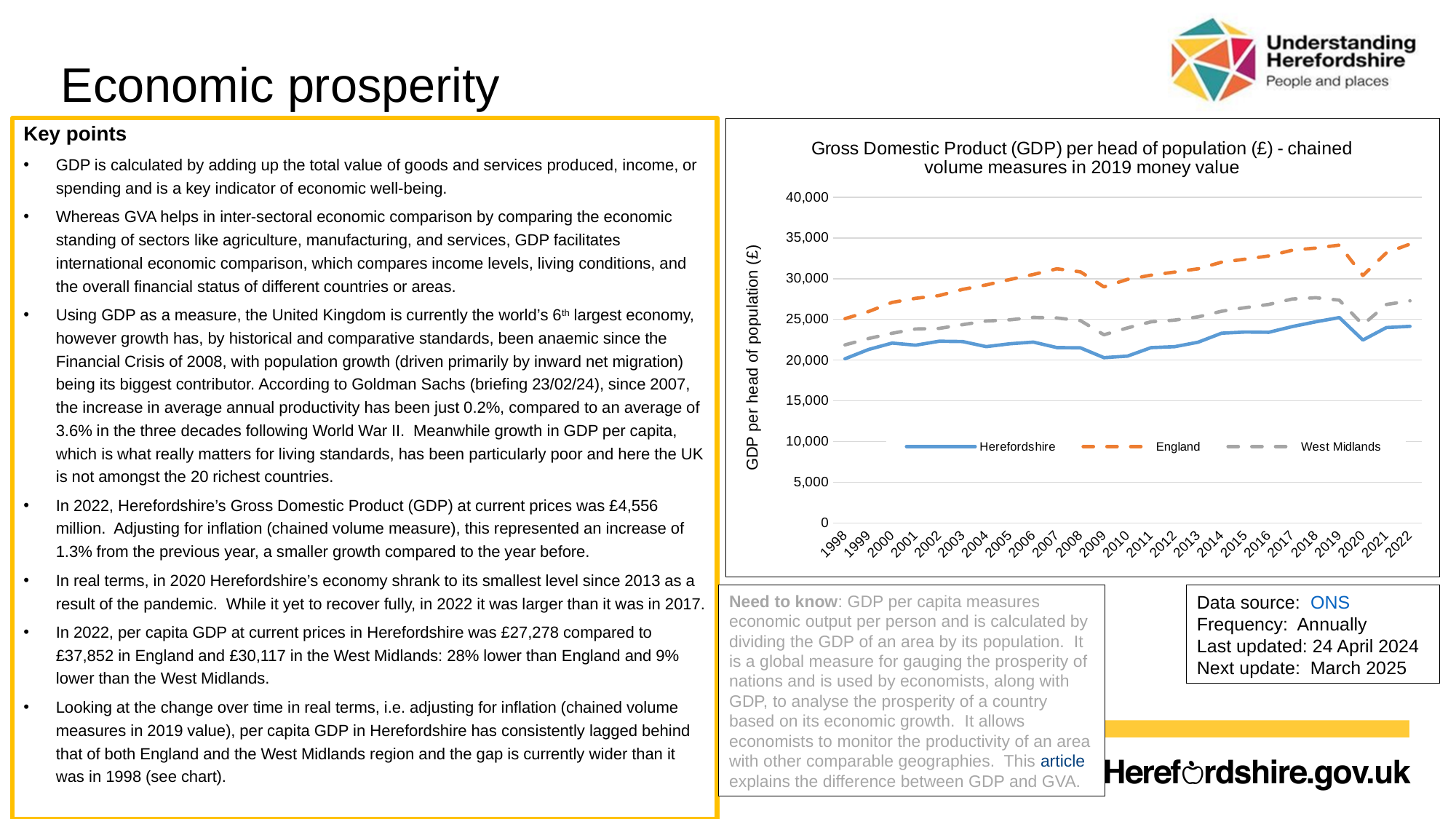
Is the value for England in 2022 greater or less than 30,000? greater How many years are plotted along the x axis of the chart? 25 Which area has the highest GDP per head of population in 2022? England How many series does the chart's legend list? 3 Does the value for England rise or fall between 2019 and 2020? Fall Is the value for Herefordshire in 2022 greater or less than 25,000? less In 2010, which is larger: the value for Herefordshire or the value for West Midlands? West Midlands What kind of chart is shown on the slide? Line chart Is the value for England in 2009 greater or less than 30,000? less Which area has the lowest GDP per head of population in 2022? Herefordshire What is the label on the vertical axis of the chart? GDP per head of population (£)